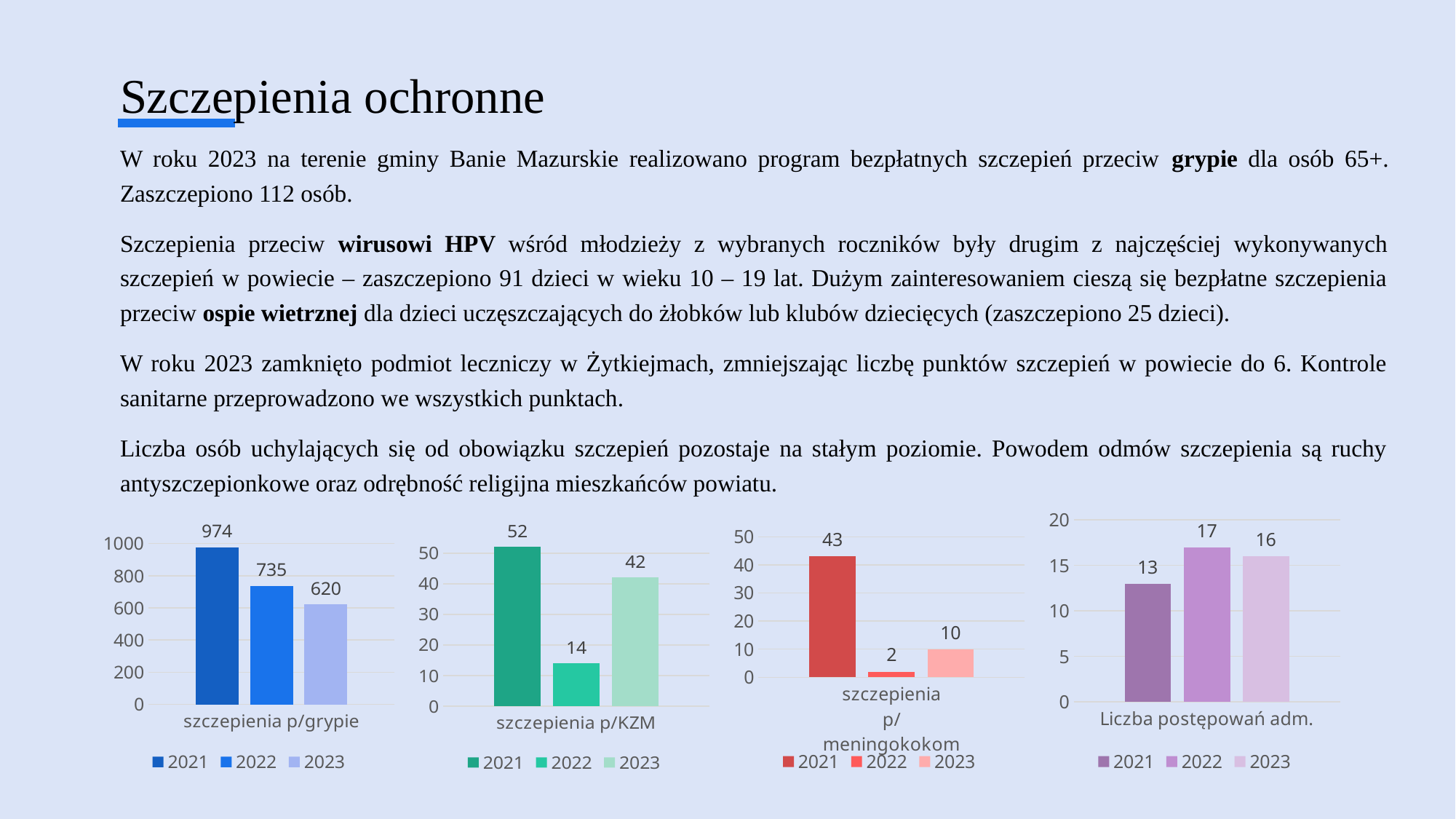
In the 'szczepienia p/grypie' chart, what is the difference between the 2021 and 2023 values? 354 In the 'szczepienia p/KZM' chart, how many series does the legend list? 3 In the 'szczepienia p/meningokokom' chart, what is the difference between the 2021 and 2023 values? 33 What kind of chart is the 'Liczba postępowań adm.' chart? bar chart In the 'szczepienia p/grypie' chart, do the values rise or fall from 2021 to 2023? fall In the 'szczepienia p/KZM' chart, what is the value for 2023? 42 In the 'szczepienia p/grypie' chart, what is the value for 2021? 974 In the 'szczepienia p/meningokokom' chart, what is the value for 2022? 2 In the 'Liczba postępowań adm.' chart, which is larger, the value for 2022 or the value for 2021? 2022 In the 'szczepienia p/meningokokom' chart, which year has the highest value? 2021 In the 'Liczba postępowań adm.' chart, what is the value for 2023? 16 In the 'szczepienia p/KZM' chart, which year has the lowest value? 2022